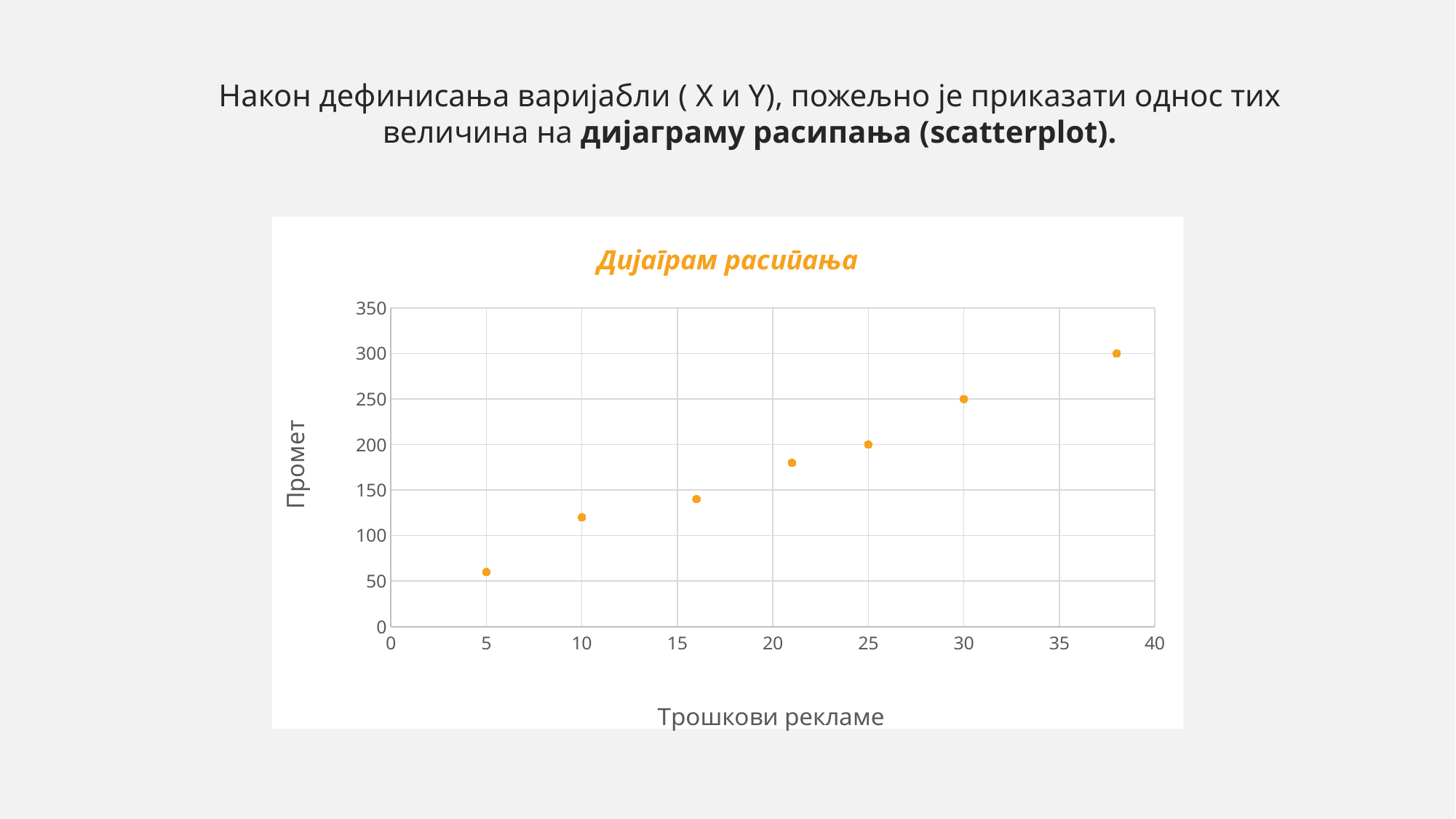
Is the Промет value of the point at Трошкови рекламе = 10 greater or less than 100? greater What is the Промет value of the point at Трошкови рекламе = 30? 250 What is the title of the chart? Дијаграм расипања Which point has the lowest Промет value: the one at Трошкови рекламе = 5 or the one at Трошкови рекламе = 10? the one at 5 Is the Промет value of the point at Трошкови рекламе = 5 greater or less than 100? less What is the Промет value of the rightmost point on the chart? 300 How many data points are plotted on the chart? 7 What is the difference in Промет between the points at Трошкови рекламе = 30 and Трошкови рекламе = 25? 50 What kind of chart is shown on the slide? scatter plot What is the Промет value of the point at Трошкови рекламе = 25? 200 What is the label of the x axis of the chart? Трошкови рекламе Do the Промет values rise or fall as Трошкови рекламе increases along the x axis? rise